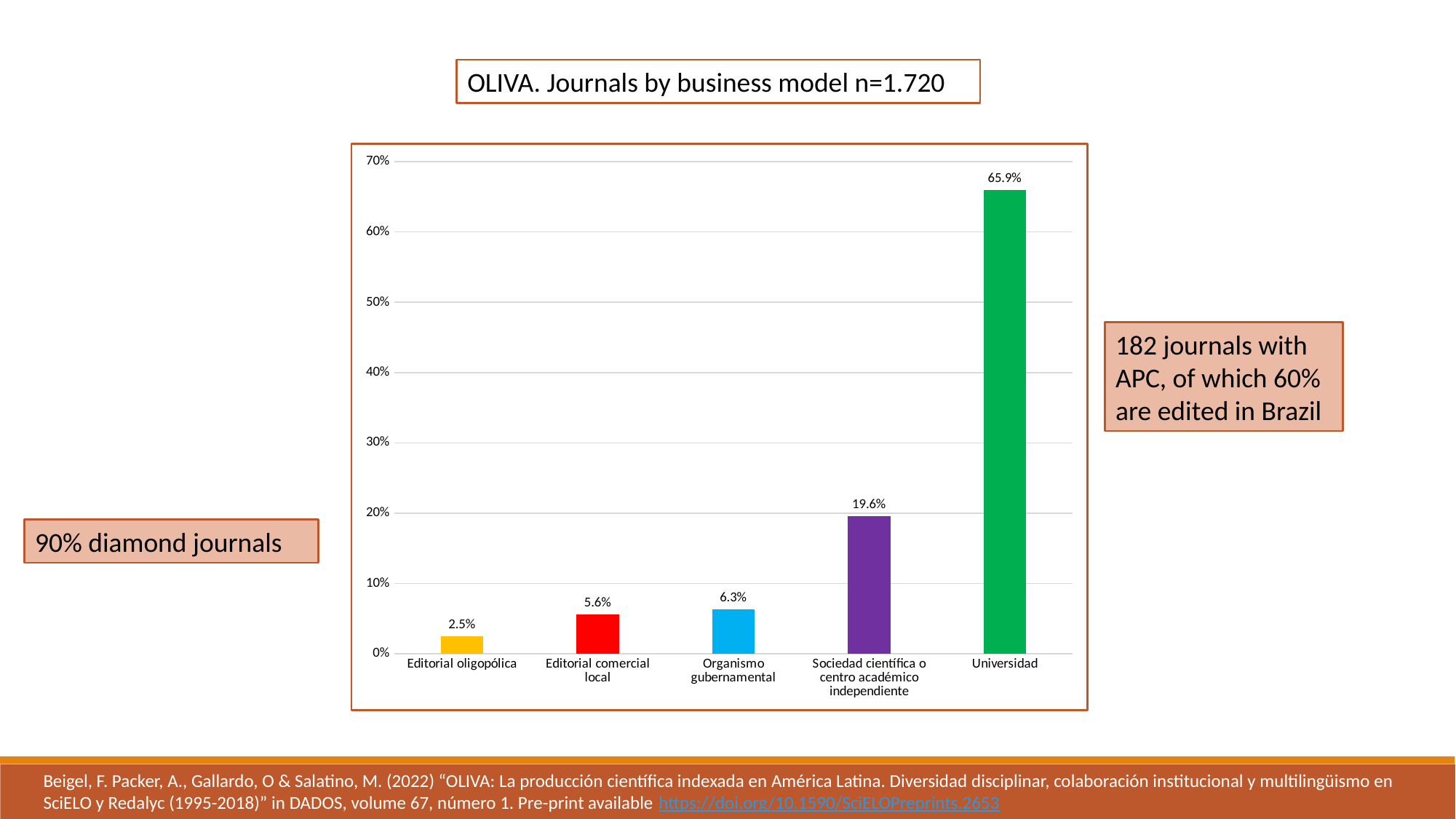
What is the difference between the values for Universidad and Sociedad científica o centro académico independiente? 46.3% What is the title of the chart? OLIVA. Journals by business model n=1.720 What kind of chart is shown on the slide? bar chart Which is larger, the value for Editorial comercial local or the value for Organismo gubernamental? Organismo gubernamental What is the value for Organismo gubernamental? 6.3% How many categories are shown on the x axis? 5 Which category has the lowest value? Editorial oligopólica Is the value for Universidad greater or less than 60%? greater What is the value for Universidad? 65.9% What is the value for Sociedad científica o centro académico independiente? 19.6% Which category has the highest value? Universidad What is the value for Editorial oligopólica? 2.5%